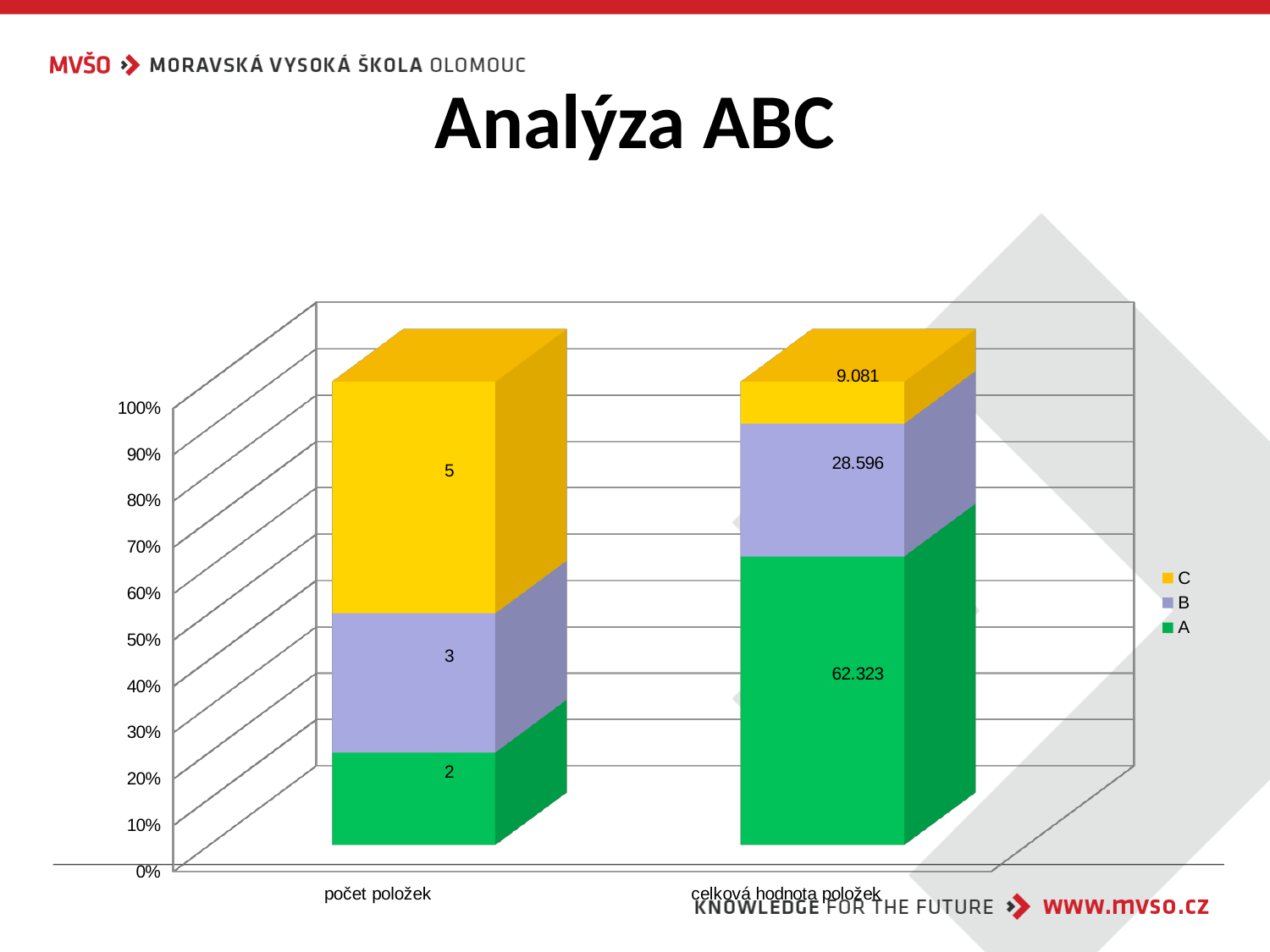
What is the difference between the values of series C and series B for počet položek? 2 What is the total of the stacked bar for počet položek? 10 What is the value of series A for počet položek? 2 For počet položek, which is larger: series B or series C? C What is the value of series C for celková hodnota položek? 9.081 What kind of chart is shown on the slide? Stacked bar chart How many series does the legend list? 3 What is the value of series B for celková hodnota položek? 28.596 What is the value of series C for počet položek? 5 Which series has the largest value for celková hodnota položek? A Which series has the smallest value for počet položek? A What is the value of series A for celková hodnota položek? 62.323